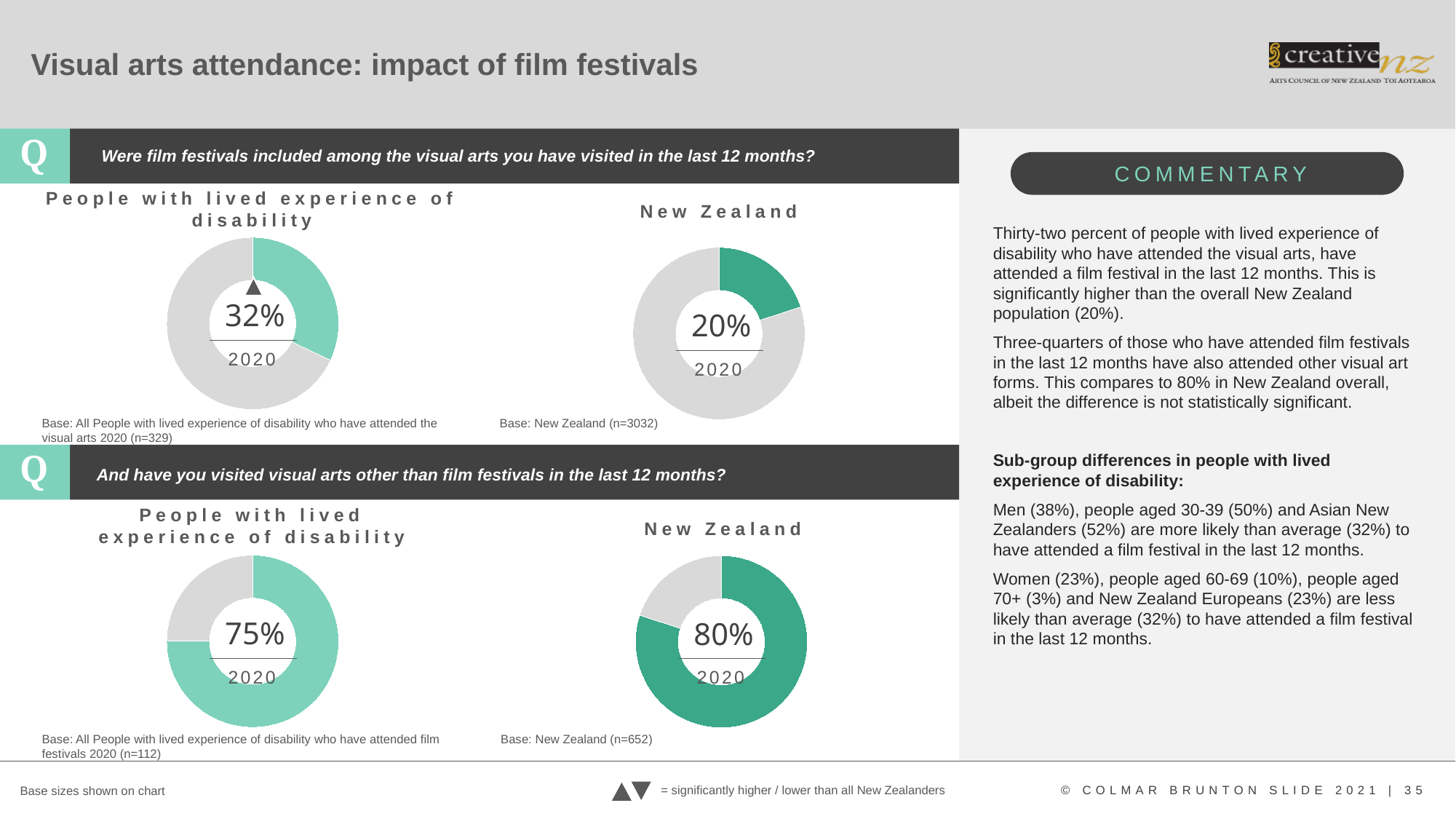
In the bottom row of charts, which group has the higher percentage: people with lived experience of disability or New Zealand? New Zealand What type of chart is used for the four charts on this slide? Donut (pie) chart What year label appears beneath the percentage in each donut chart? 2020 In the top row of charts, which group has the higher percentage: people with lived experience of disability or New Zealand? People with lived experience of disability Which of the four donut charts shows the highest percentage? New Zealand (bottom-right), 80% In the top-right donut chart (New Zealand, film festivals question), what percentage is shown in the centre? 20% Which of the four donut charts shows the lowest percentage? New Zealand (top-right), 20% In the top-left donut chart (People with lived experience of disability, film festivals question), what percentage is shown in the centre? 32% For the visual arts other than film festivals question (bottom row), what is the difference between the New Zealand percentage and the percentage for people with lived experience of disability? 5 percentage points In the bottom-left donut chart (People with lived experience of disability, visual arts other than film festivals), what percentage is shown? 75% In the bottom-right donut chart (New Zealand, visual arts other than film festivals), what percentage is shown? 80% For the film festivals question (top row), what is the difference between the percentage for people with lived experience of disability and the percentage for New Zealand? 12 percentage points